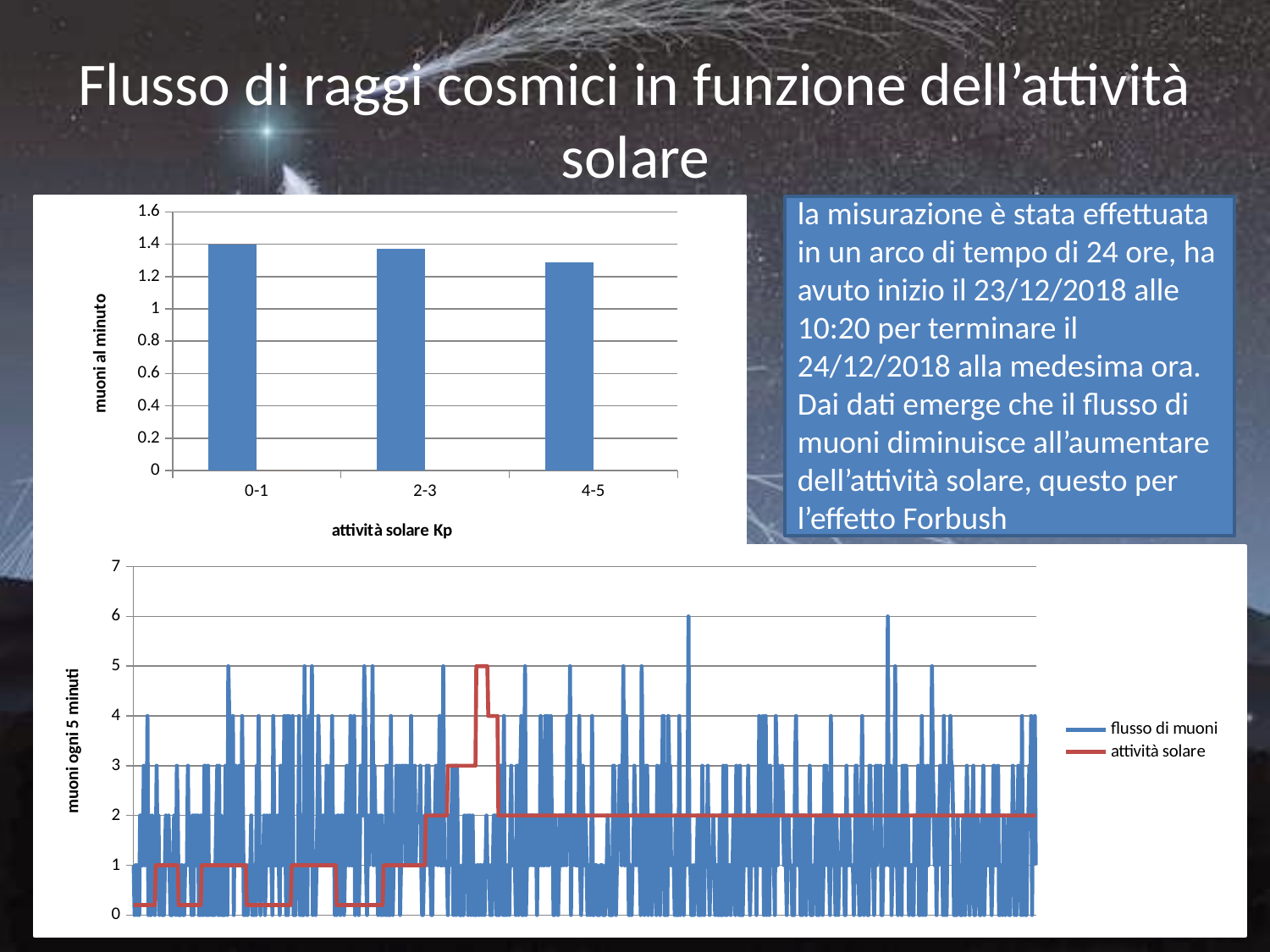
In the top bar chart, is the value for the 2-3 category greater or less than 1.2? greater In the top bar chart, is the value for the 4-5 category greater or less than 1.4? less In the top bar chart, which solar activity (Kp) category has the highest muon rate? 0-1 In the top bar chart, do the values rise or fall as solar activity Kp increases along the x axis? fall In the top bar chart, which solar activity (Kp) category has the lowest muon rate? 4-5 In the top bar chart, is the value for the 0-1 category greater or less than 1.2? greater What kind of chart is the top chart on the slide? bar chart In the top bar chart, which is larger: the value for 0-1 or the value for 4-5? 0-1 How many categories are shown on the x axis of the top bar chart? 3 What are the two series named in the legend of the bottom chart? flusso di muoni, attività solare How many series does the legend of the bottom line chart list? 2 What is the y-axis title of the top bar chart? muoni al minuto